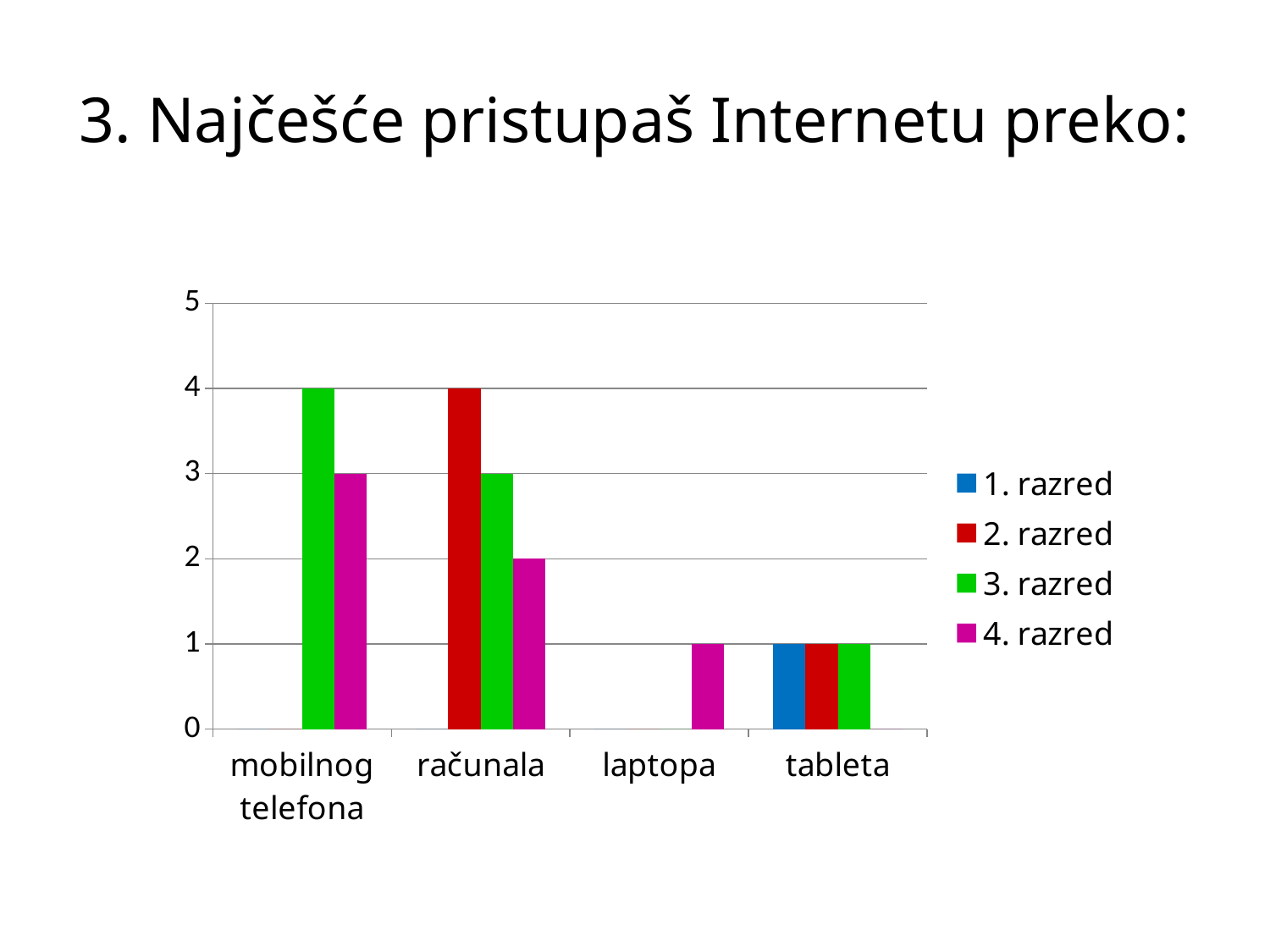
Which is larger: the 4. razred value for mobilnog telefona or the 4. razred value for računala? mobilnog telefona What is the value for 4. razred in the računala category? 2 What is the difference between the 3. razred value for mobilnog telefona and the 3. razred value for računala? 1 What is the title of the slide? 3. Najčešće pristupaš Internetu preko: How many series does the legend list? 4 Which series has the highest value in the računala category? 2. razred What is the value for 4. razred in the laptopa category? 1 What kind of chart is shown on the slide? bar chart What is the value for 2. razred in the računala category? 4 What is the value for 3. razred in the mobilnog telefona category? 4 How many categories are shown on the x axis? 4 Which category is the only one with a bar for 1. razred? tableta